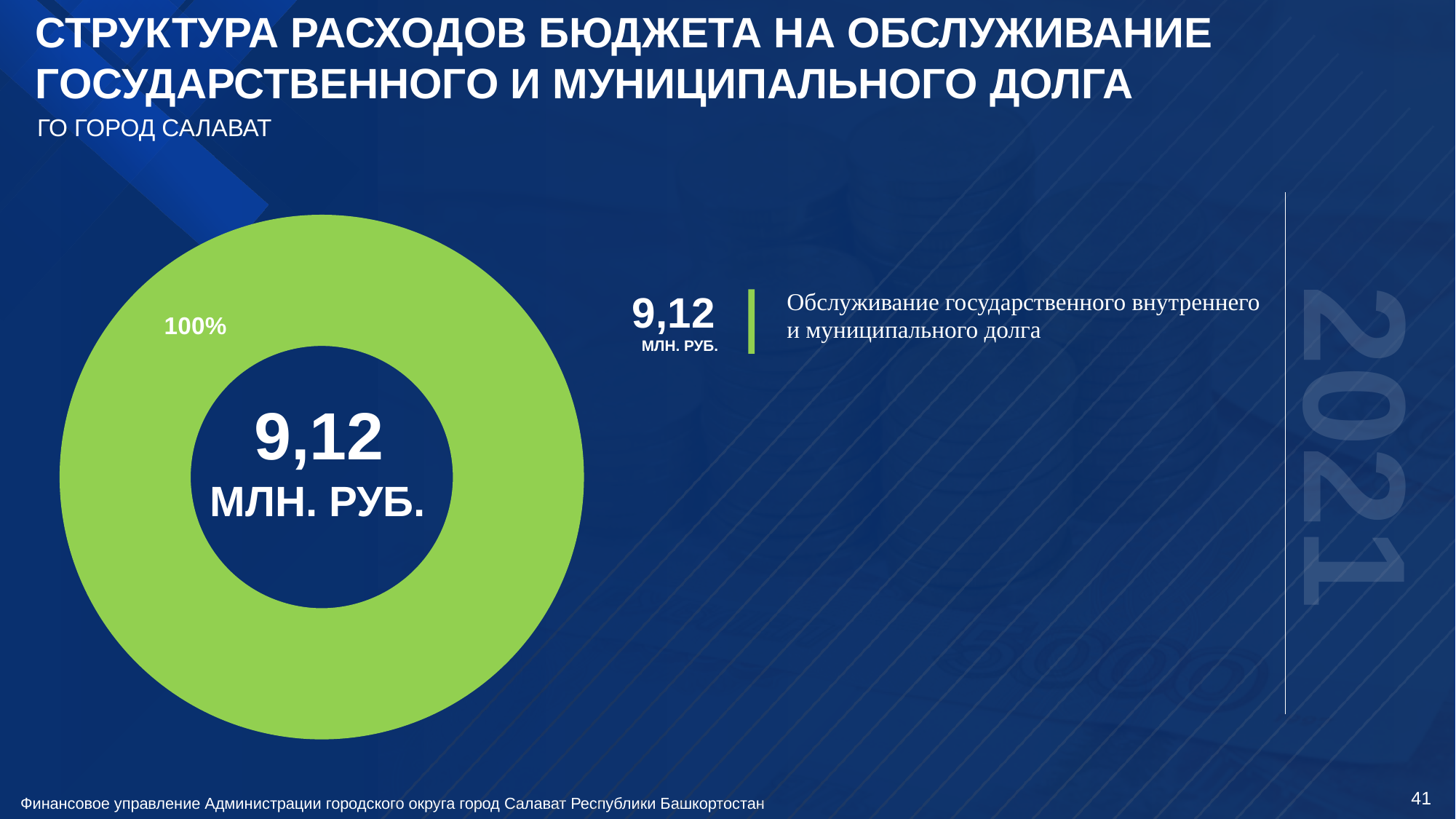
Which category is the largest in the donut chart? Обслуживание государственного внутреннего и муниципального долга What total value is printed in the centre of the donut chart? 9,12 млн. руб. What value is shown for "Обслуживание государственного внутреннего и муниципального долга"? 9,12 млн. руб. What percentage label is printed on the green slice of the donut chart? 100% What colour is the single slice of the donut chart? Green How many slices does the donut chart have? 1 What kind of chart is shown on the slide? Pie (donut) chart What is the title of the slide containing the donut chart? СТРУКТУРА РАСХОДОВ БЮДЖЕТА НА ОБСЛУЖИВАНИЕ ГОСУДАРСТВЕННОГО И МУНИЦИПАЛЬНОГО ДОЛГА In what unit is the value in the centre of the donut chart expressed? млн. руб. What share of the donut chart does the slice for "Обслуживание государственного внутреннего и муниципального долга" take? 100%